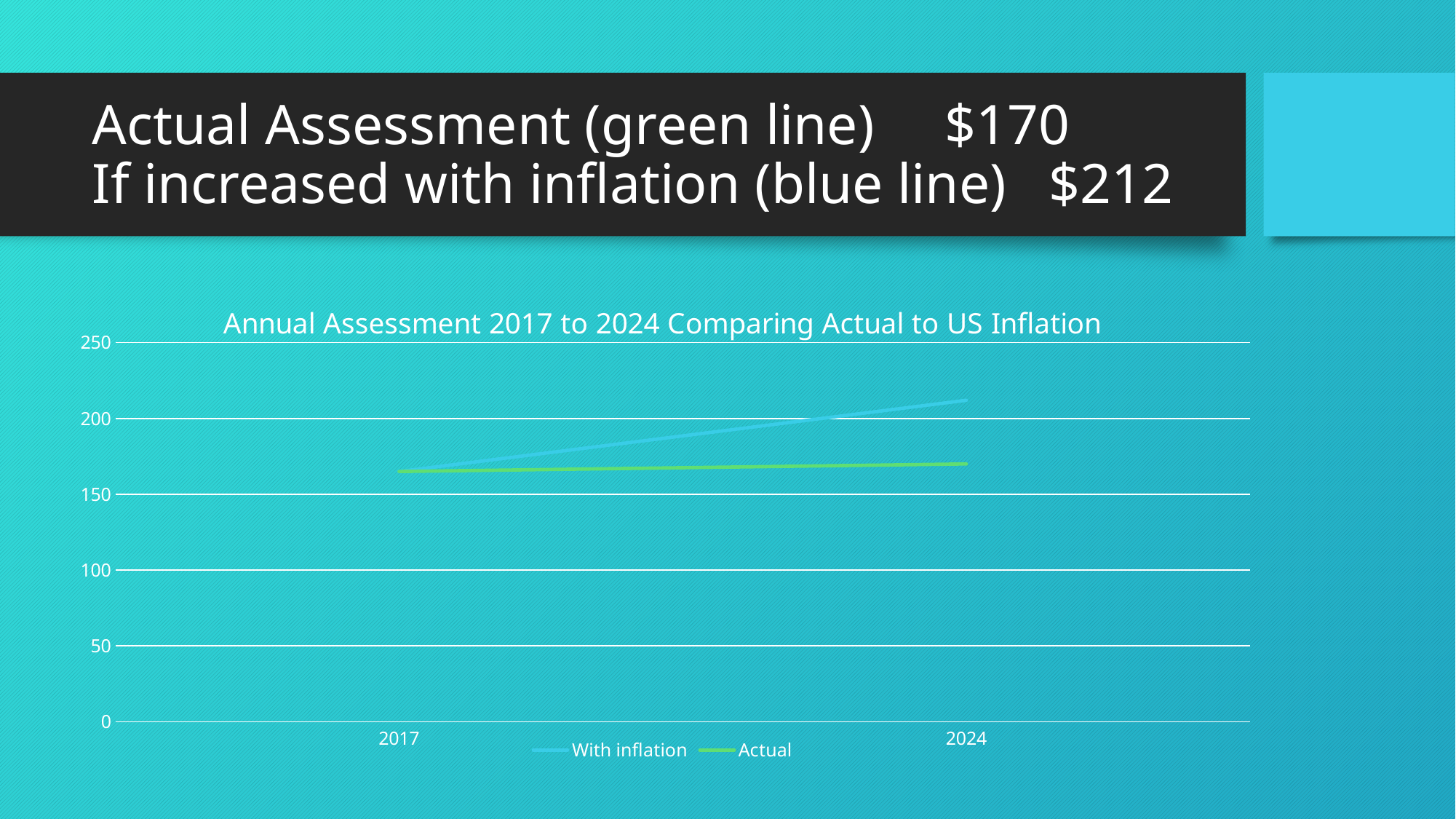
According to the slide, what is the Actual assessment value (green line) in 2024? $170 How many series does the chart legend list? 2 In 2024, which series is higher: With inflation or Actual? With inflation Does the With inflation line rise or fall from 2017 to 2024? rises Is the value for With inflation in 2017 greater or less than 200? less Is the value for Actual in 2017 greater or less than 150? greater What kind of chart is shown on the slide? line chart What is the difference between the With inflation value and the Actual value in 2024, as stated on the slide? $42 What is the title of the chart? Annual Assessment 2017 to 2024 Comparing Actual to US Inflation According to the slide, what is the With inflation value (blue line) in 2024? $212 How many years are shown on the x axis of the chart? 2 What colour is the Actual line in the chart? green